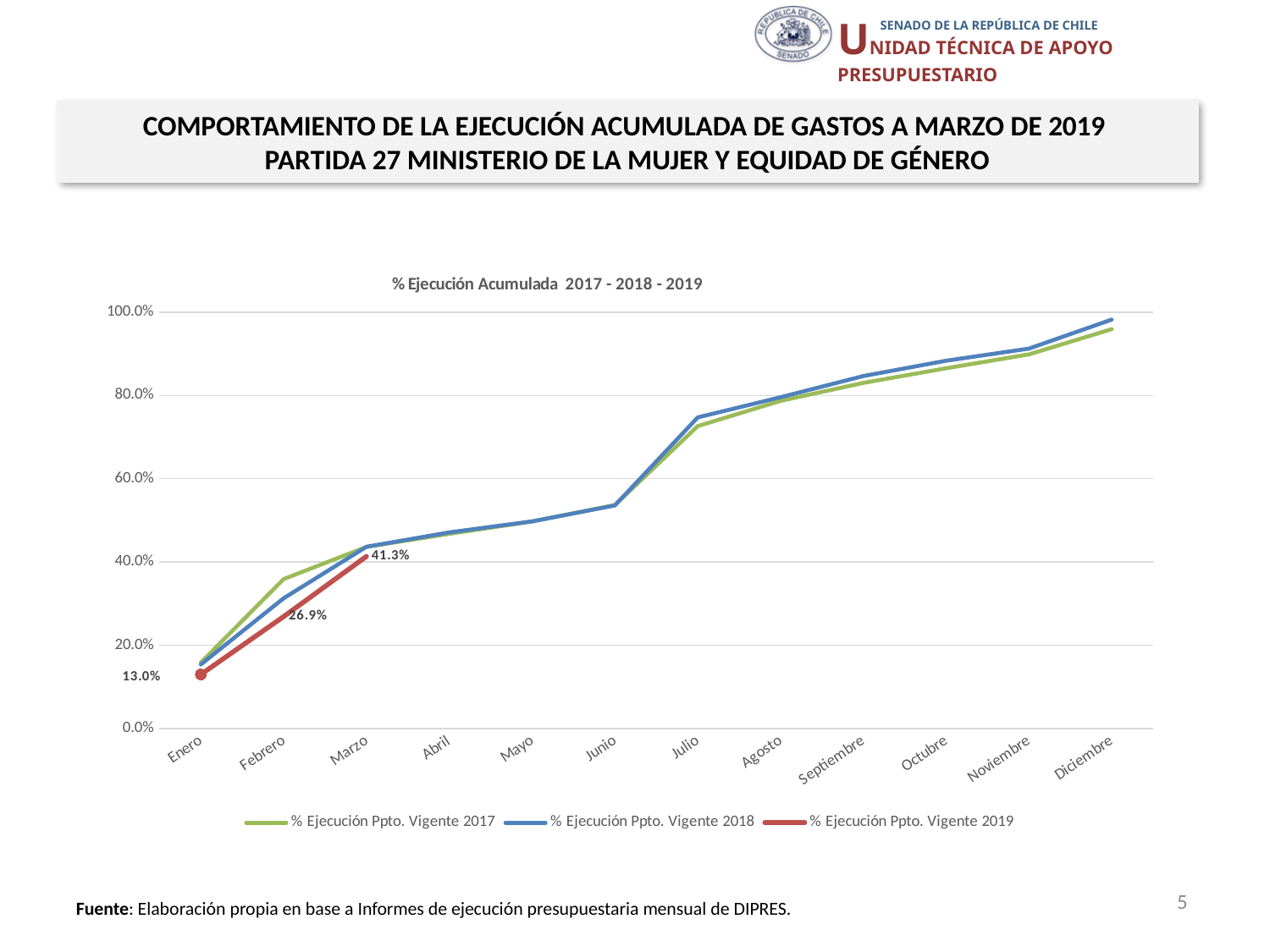
Is the value for % Ejecución Ppto. Vigente 2018 in Diciembre greater or less than 80.0%? greater How many series does the legend list? 3 What kind of chart is shown on the slide? Line chart Which month has the highest value for the % Ejecución Ppto. Vigente 2019 series? Marzo Does the % Ejecución Ppto. Vigente 2018 series rise or fall from Enero to Diciembre? Rise What is the value of % Ejecución Ppto. Vigente 2019 for Enero? 13.0% What is the value of % Ejecución Ppto. Vigente 2019 for Febrero? 26.9% What is the difference between the 2019 values for Marzo and Febrero? 14.4% What is the title of the chart? % Ejecución Acumulada 2017 - 2018 - 2019 What is the value of % Ejecución Ppto. Vigente 2019 for Marzo? 41.3% How many months are shown on the x axis? 12 What is the difference between the 2019 values for Marzo and Enero? 28.3%